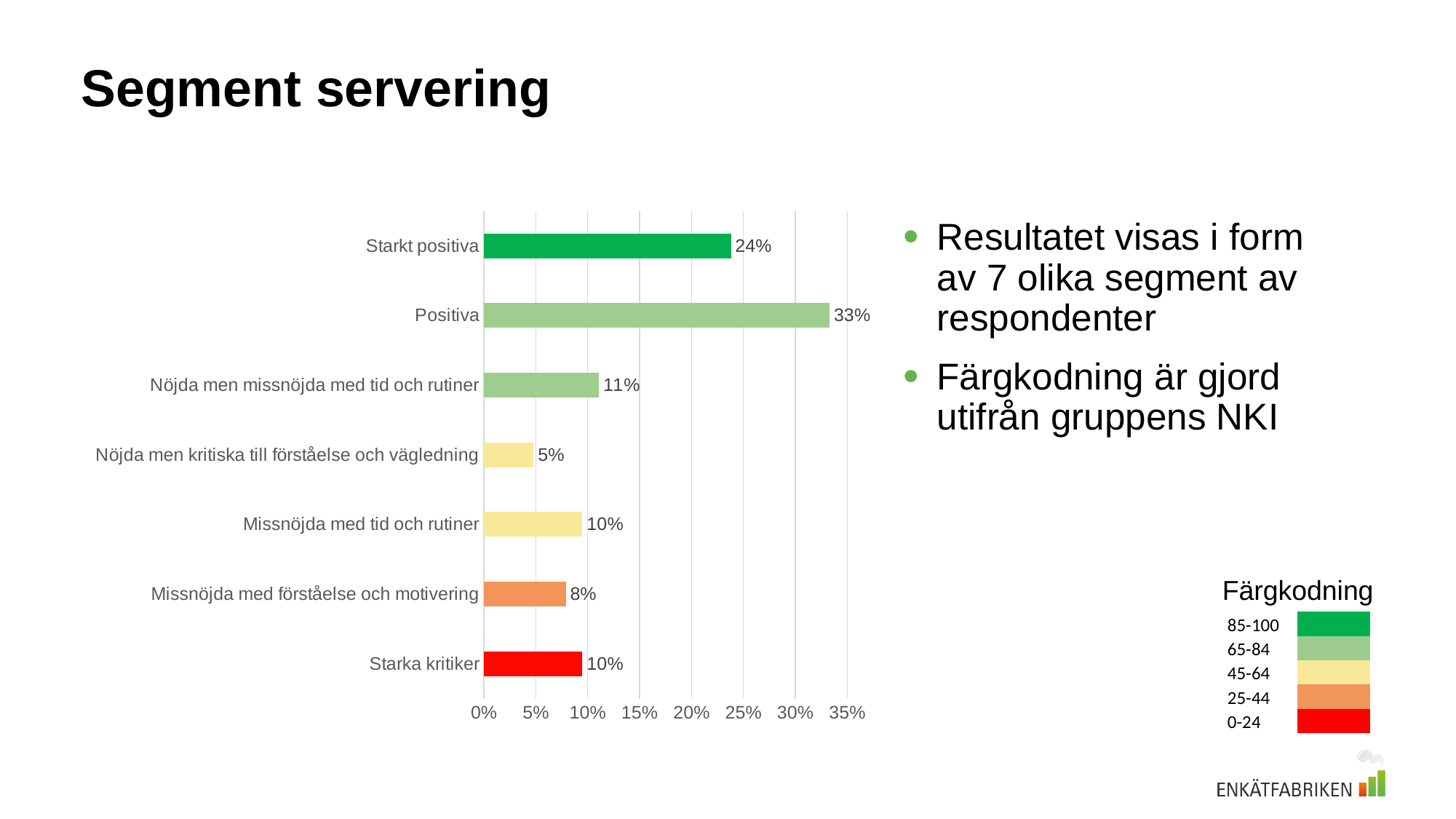
Is the value for Starkt positiva greater or less than 20%? greater How many categories are shown in the chart? 7 What is the value for Nöjda men kritiska till förståelse och vägledning? 5% Which category has the lowest value? Nöjda men kritiska till förståelse och vägledning Which category has the highest value? Positiva What is the value for Starkt positiva? 24% What is the difference between the values for Positiva and Starkt positiva? 9% Which is larger, the value for Nöjda men missnöjda med tid och rutiner or the value for Missnöjda med förståelse och motivering? Nöjda men missnöjda med tid och rutiner What is the value for Positiva? 33% What colour is the bar for Starka kritiker? red What kind of chart is shown on the slide? bar chart What is the value for Missnöjda med förståelse och motivering? 8%